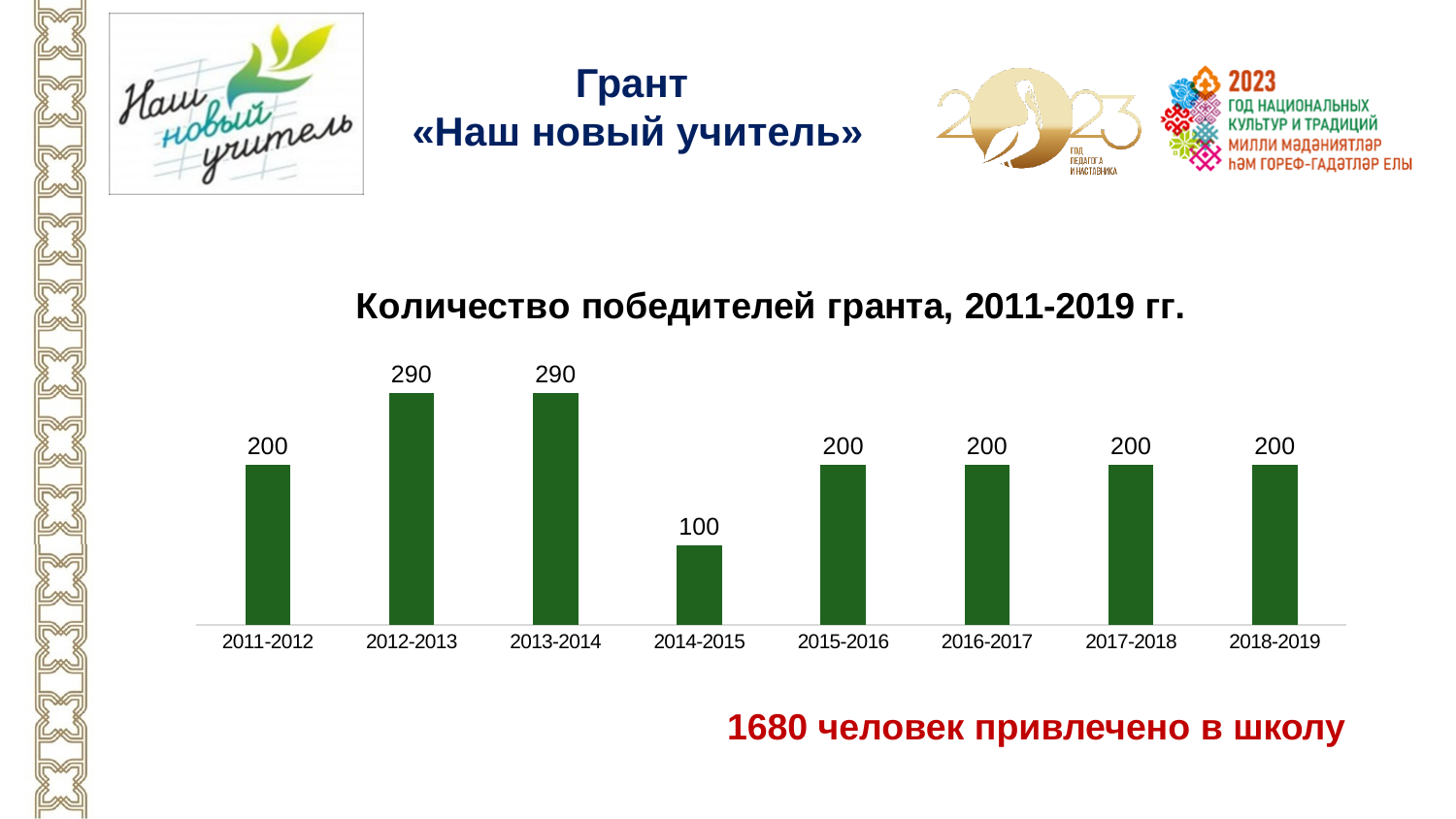
What is the title of the chart? Количество победителей гранта, 2011-2019 гг. What is the value for 2013-2014? 290 Which is larger, the value for 2014-2015 or the value for 2017-2018? 2017-2018 What colour are the bars in the chart? green How many categories are shown on the x axis? 8 What is the difference between the values for 2012-2013 and 2014-2015? 190 What is the difference between the values for 2013-2014 and 2018-2019? 90 Which category has the lowest value? 2014-2015 Which is larger, the value for 2012-2013 or the value for 2015-2016? 2012-2013 What kind of chart is shown on the slide? bar chart What is the value for 2014-2015? 100 What is the value for 2011-2012? 200